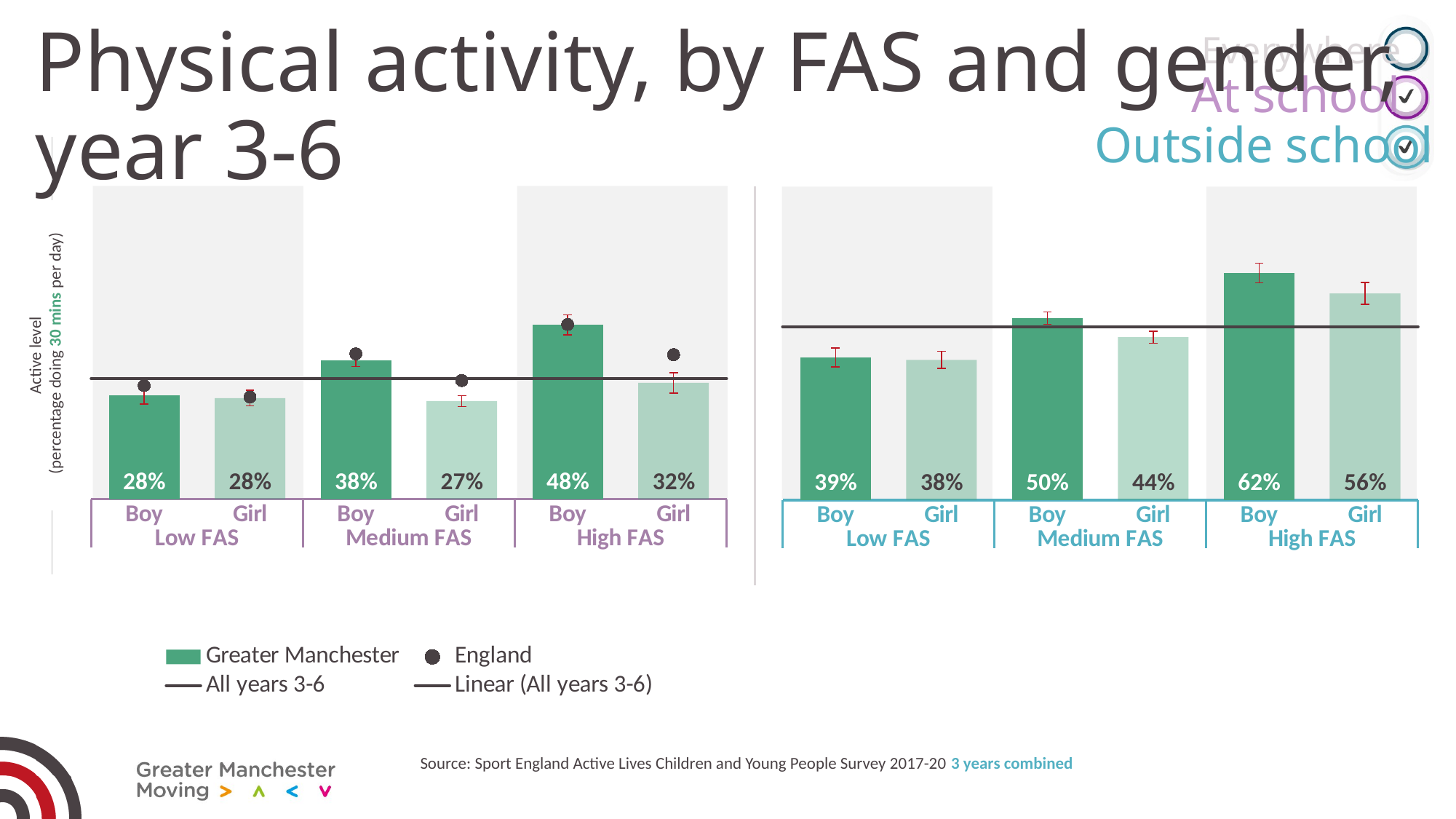
In the Outside school chart (right), what is the difference between the Boy and Girl values in Medium FAS? 6% In the Outside school chart (right), what is the Greater Manchester value for Girl in Medium FAS? 44% In the At school chart (left), what is the difference between the Boy and Girl values in High FAS? 16% In the Outside school chart (right), what is the Greater Manchester value for Boy in High FAS? 62% In the Outside school chart (right), which bar has the lowest Greater Manchester value? Girl, Low FAS In the At school chart (left), what is the Greater Manchester value for Boy in Low FAS? 28% In the Outside school chart (right), which is larger: the Boy value in Medium FAS or the Girl value in High FAS? Girl in High FAS In the At school chart (left), which bar has the lowest Greater Manchester value? Girl, Medium FAS How many entries does the legend list? 4 In the At school chart (left), which bar has the highest Greater Manchester value? Boy, High FAS How many bars are plotted in the Outside school chart (right)? 6 In the At school chart (left), what is the Greater Manchester value for Girl in Medium FAS? 27%